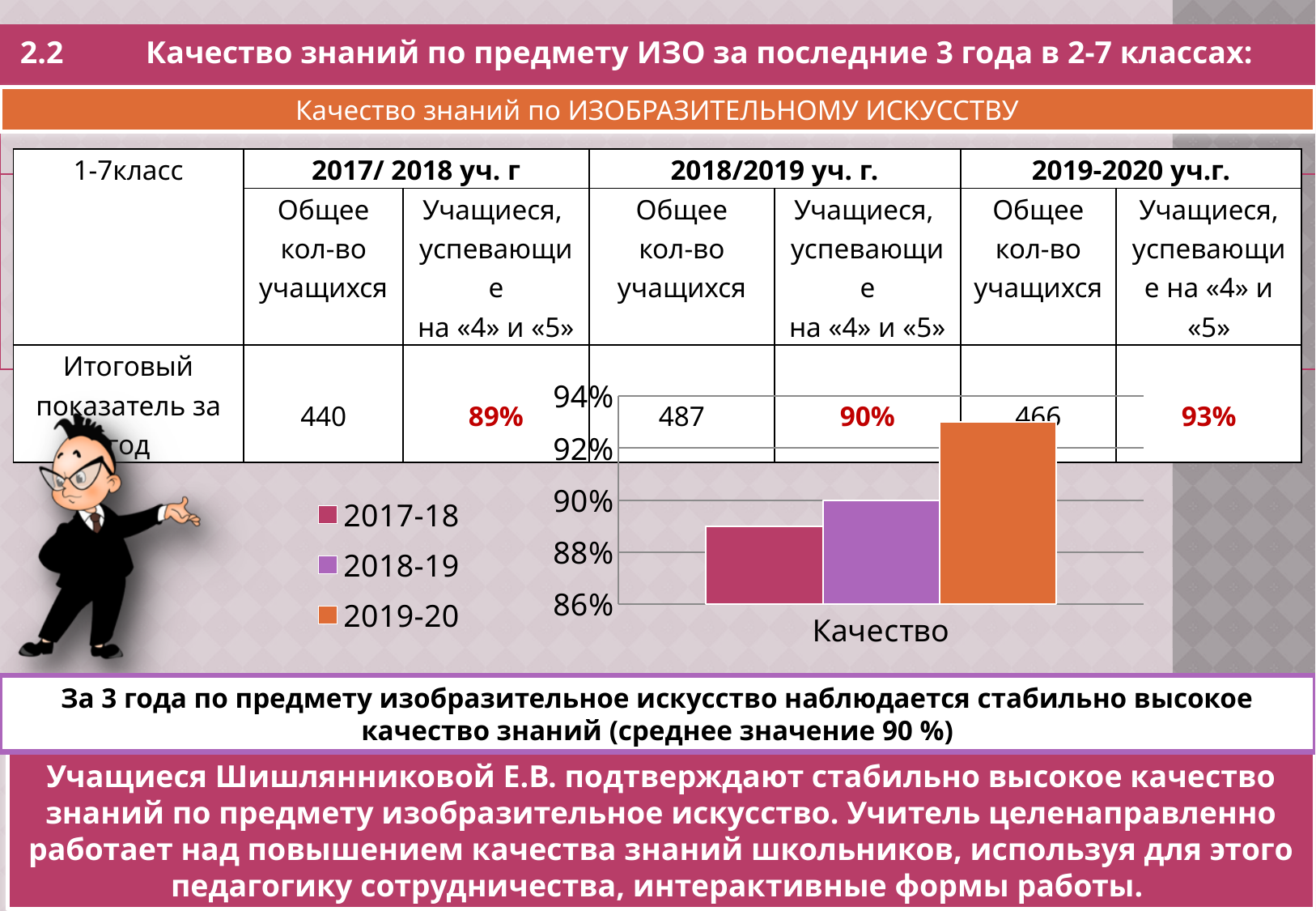
How many categories are shown on the x axis of the chart? 1 Is the value for the 2017-18 series greater or less than 90%? less Which is larger in the chart, the 2018-19 bar or the 2017-18 bar? 2018-19 What colour is the bar for the 2019-20 series? orange What is the category label shown under the bars on the x axis? Качество Do the bar values rise or fall from 2017-18 to 2019-20? rise Which series has the lowest bar in the chart? 2017-18 How many series does the chart legend list? 3 What kind of chart is shown on the slide? bar chart What is the value for the 2018-19 series in the chart? 90% Is the value for the 2019-20 series greater or less than 92%? greater Which series has the highest bar in the chart? 2019-20